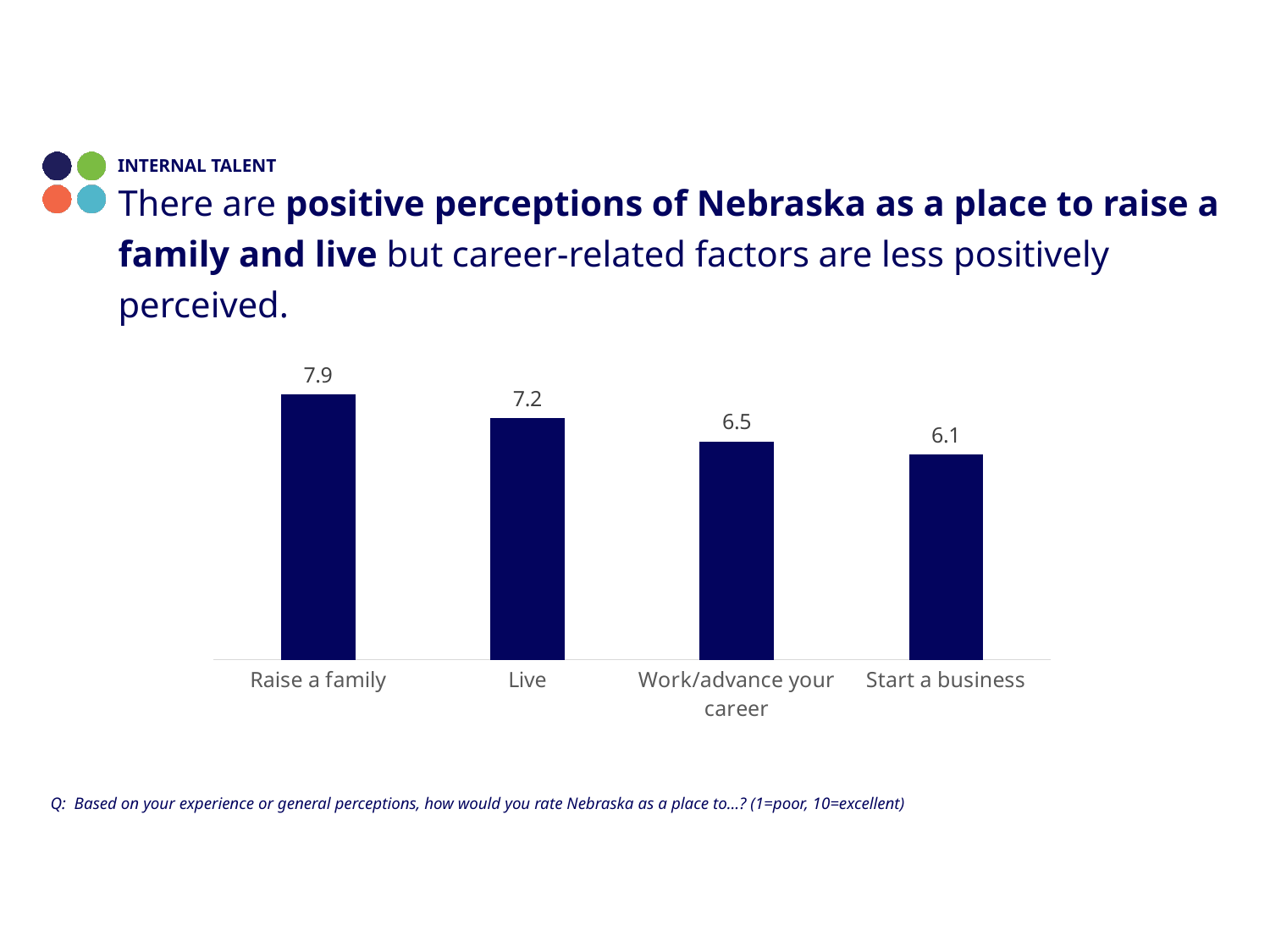
What is the rating for Nebraska as a place to work/advance your career? 6.5 Do the ratings rise or fall from left to right across the categories? Fall What is the rating for Nebraska as a place to start a business? 6.1 What is the rating for Nebraska as a place to raise a family? 7.9 What is the difference between the ratings for live and work/advance your career? 0.7 What is the rating for Nebraska as a place to live? 7.2 Which has a higher rating, Live or Work/advance your career? Live Which category has the lowest rating? Start a business What is the difference between the ratings for raising a family and starting a business? 1.8 How many categories are shown in the chart? 4 What type of chart is shown on the slide? Bar chart Which category has the highest rating? Raise a family